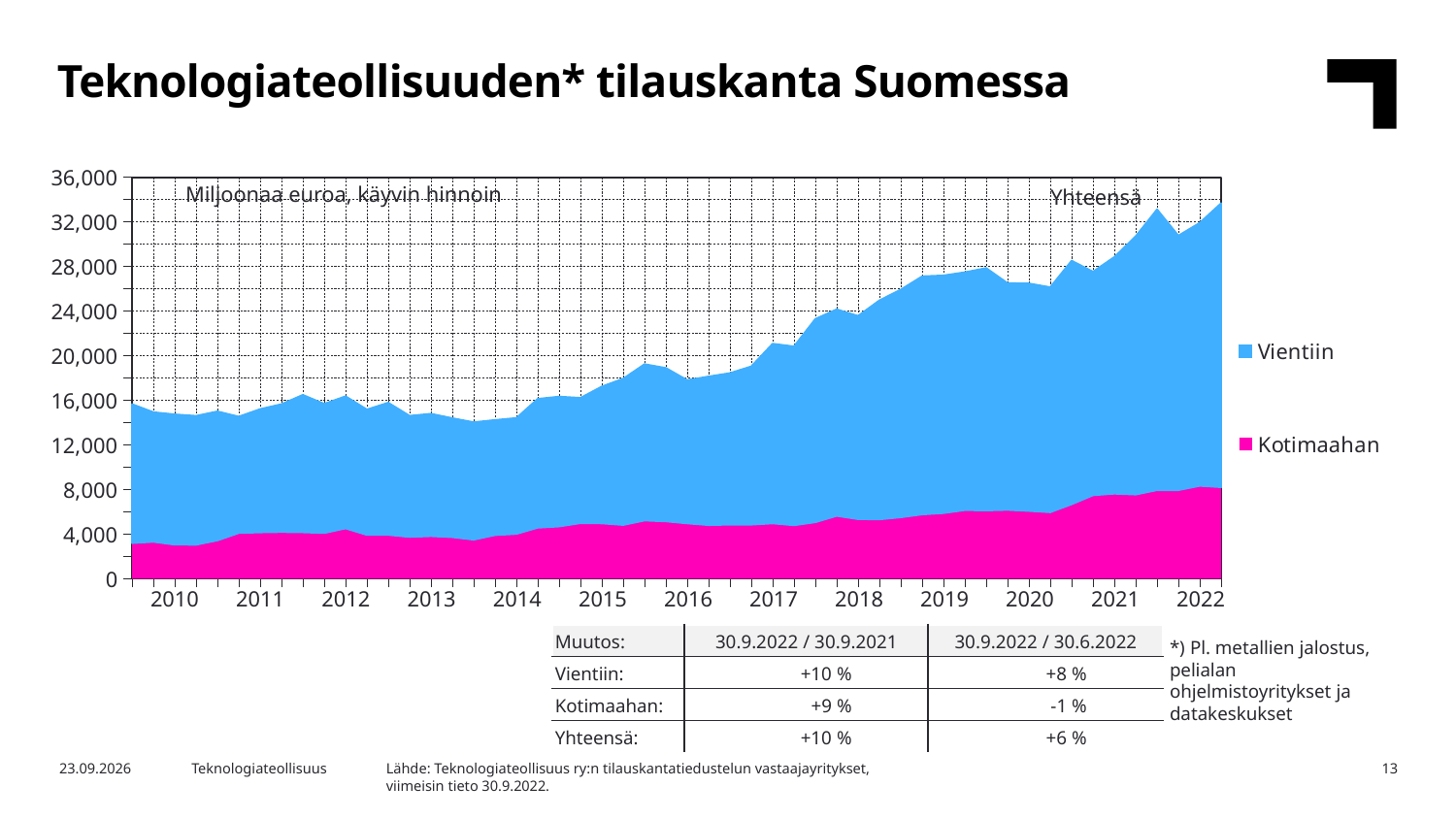
What unit is stated for the values in the chart? Miljoonaa euroa, käyvin hinnoin How many series does the legend list? 2 In which year does the total order book reach its highest level? 2022 What are the two series named in the legend? Vientiin and Kotimaahan Is the total (Yhteensä) value at the end of 2022 greater or less than 28,000? greater What kind of chart is shown on the slide? Stacked area chart Does the total order book (Yhteensä) generally rise or fall from 2010 to 2022? Rise How many years are labelled on the x axis? 13 Is the Kotimaahan value at the end of 2022 greater or less than 4,000? greater Is the total (Yhteensä) value at the start of 2010 greater or less than 20,000? less Which series is larger throughout the chart, Vientiin or Kotimaahan? Vientiin